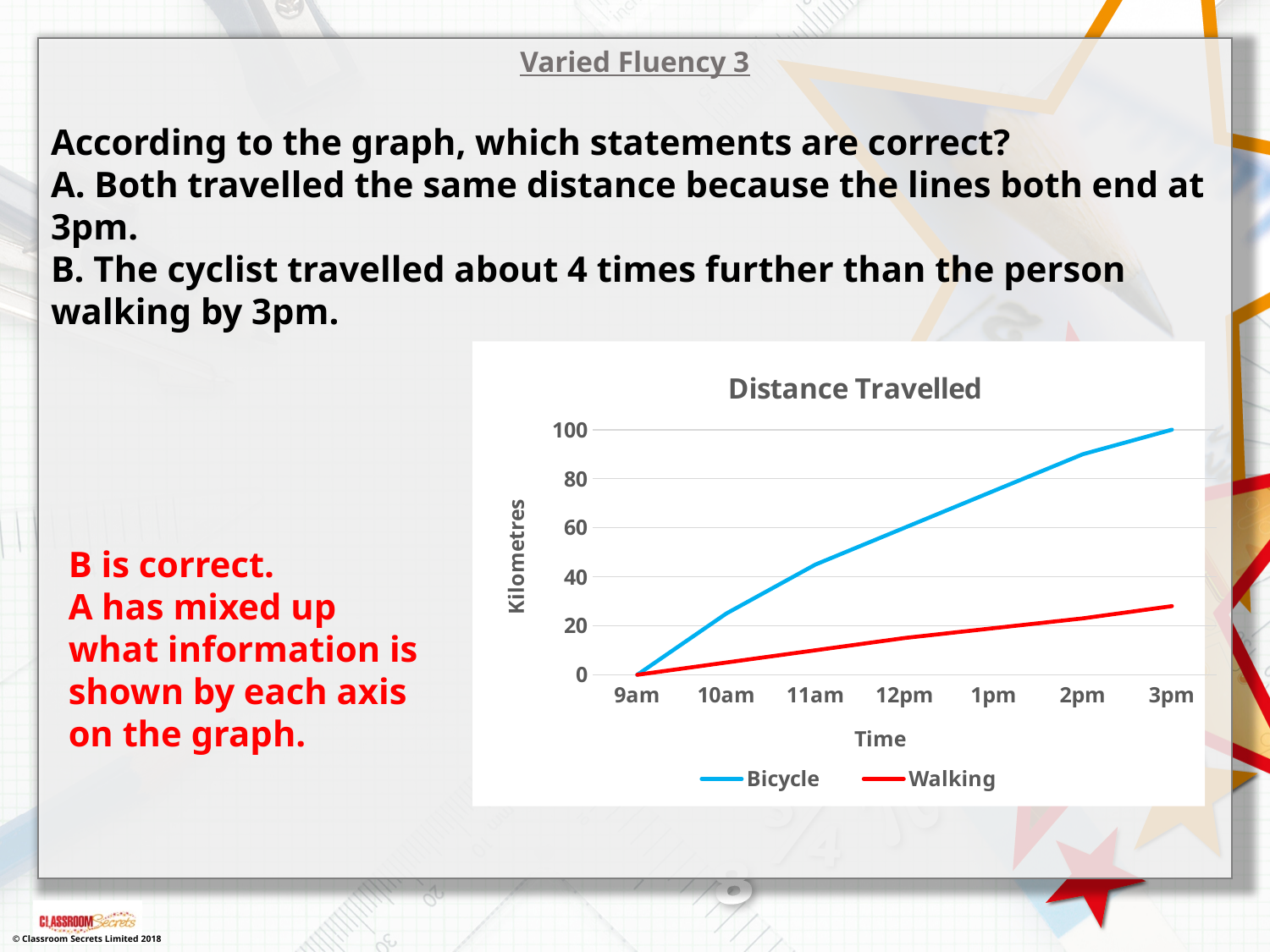
How many time points are shown on the x axis of the Distance Travelled chart? 7 Do the Bicycle values rise or fall from 9am to 3pm? rise Which series has the larger value at 1pm, Bicycle or Walking? Bicycle What kind of chart is shown on the slide? line chart What is the Walking value at 9am? 0 How many series does the legend of the Distance Travelled chart list? 2 Is the Walking value at 3pm greater or less than 40? less Is the Walking value at 12pm greater or less than 20? less What is the Bicycle value at 3pm? 100 Is the Bicycle value at 12pm greater or less than 40? greater What is the title of the chart? Distance Travelled What is the label of the vertical axis of the chart? Kilometres